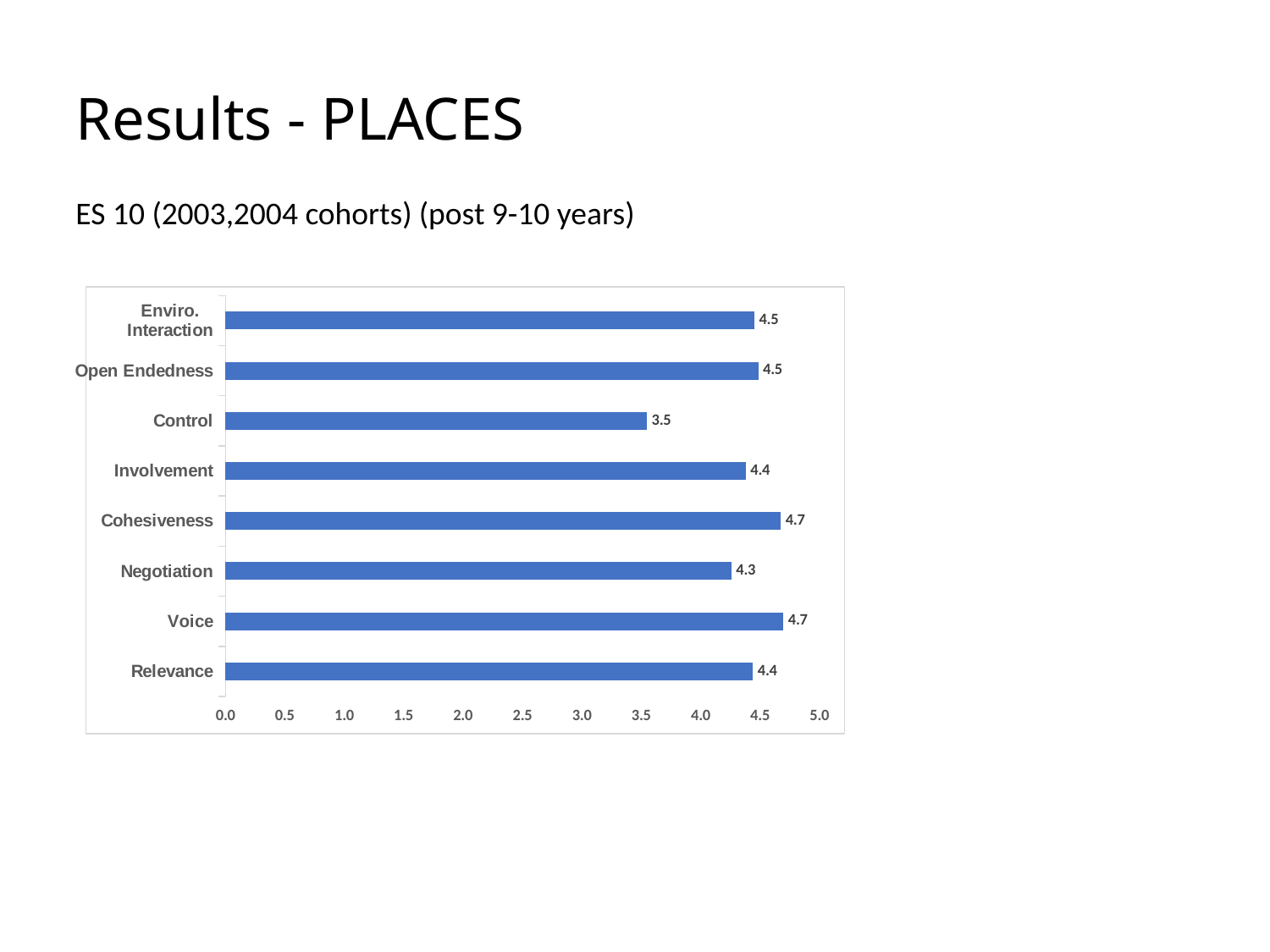
What is the difference between the values for Voice and Negotiation? 0.4 Which category has the lowest value? Control What is the difference between the values for Cohesiveness and Control? 1.2 What kind of chart is shown on the slide? bar chart What is the value for Cohesiveness? 4.7 How many categories are shown in the chart? 8 Is the value for Control greater or less than 4.0? less What is the value for Control? 3.5 What is the value for Relevance? 4.4 Which is larger, the value for Negotiation or the value for Control? Negotiation What is the value for Negotiation? 4.3 What is the value for Open Endedness? 4.5